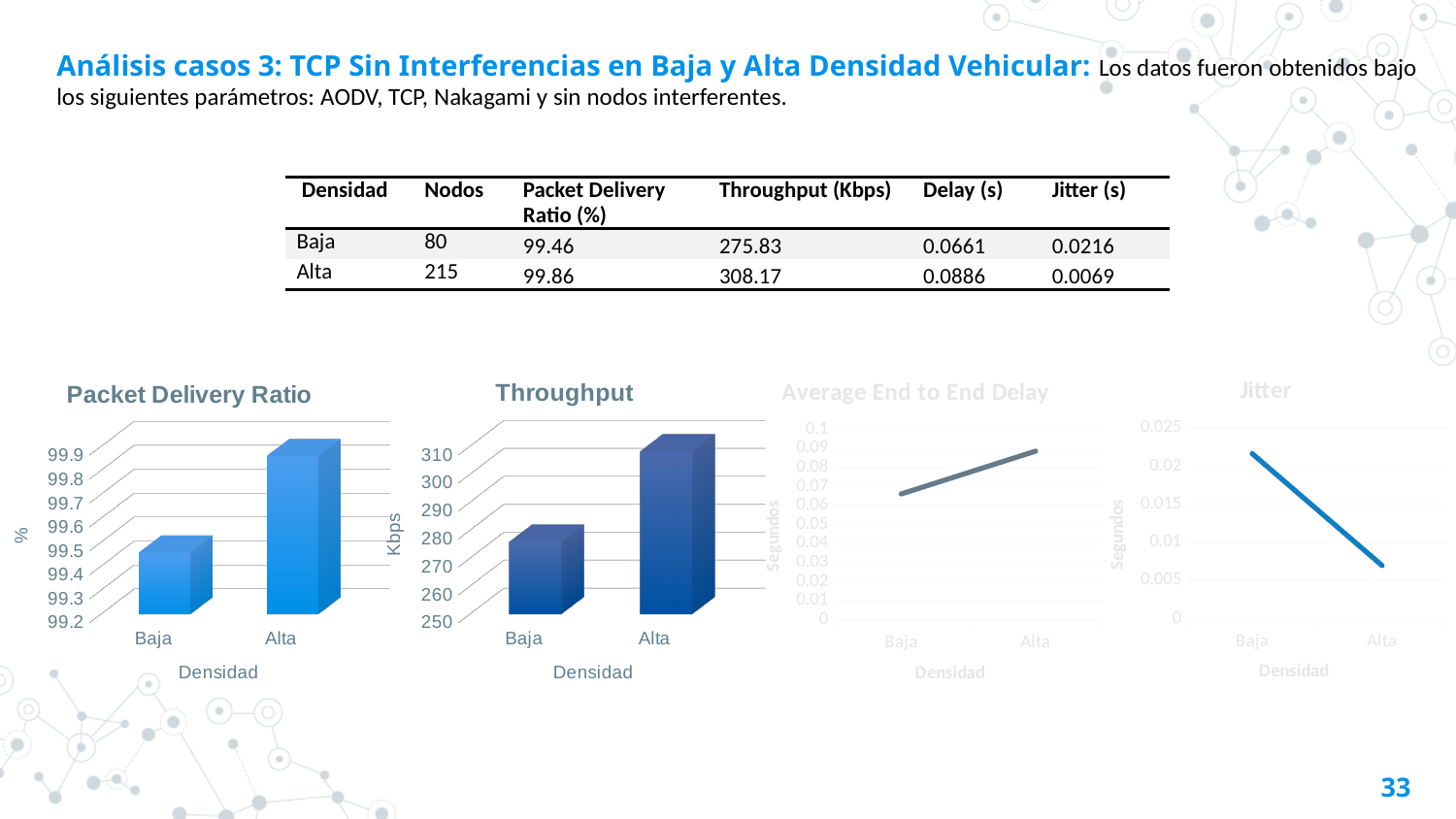
In the Packet Delivery Ratio chart, which is larger, Baja or Alta? Alta In the Average End to End Delay chart, does the value rise or fall from Baja to Alta? rise In the Jitter chart, is the value for Baja greater or less than 0.015? greater In the Throughput chart, which category has the highest value? Alta In the Jitter chart, does the value rise or fall from Baja to Alta? fall What kind of chart is the Jitter chart? line chart In the Throughput chart, is the value for Alta greater or less than 300? greater In the Average End to End Delay chart, is the value for Alta greater or less than 0.08? greater How many categories are shown on the x axis of the Packet Delivery Ratio chart? 2 What is the y-axis label of the Throughput chart? Kbps What kind of chart is the Packet Delivery Ratio chart? bar chart